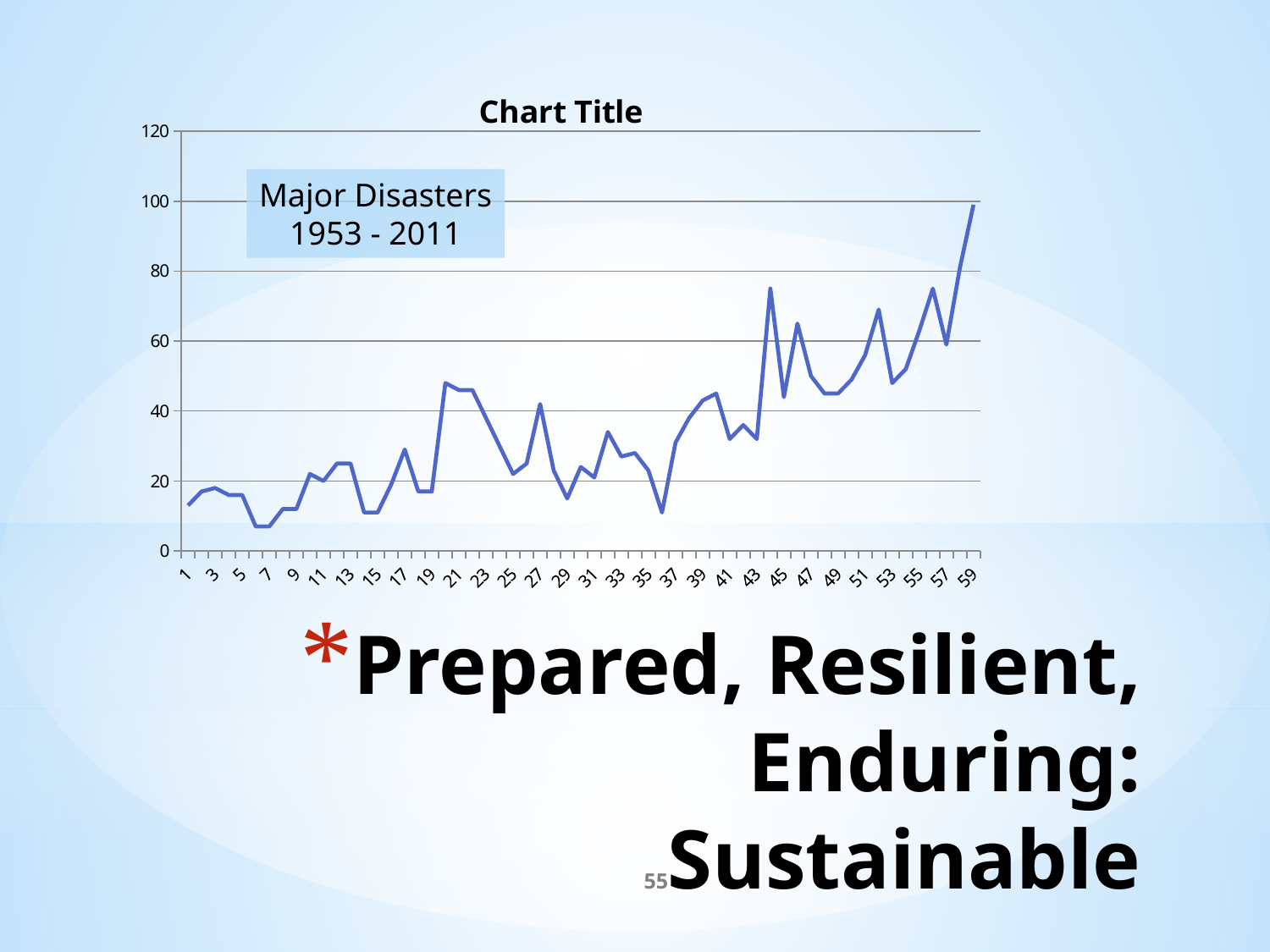
At which x-axis point does the line reach its highest value? 59 What kind of chart is shown on the slide? line chart Is the value at point 20 greater or less than 40? greater What is the highest value shown on the y axis? 120 What does the text box inside the chart say? Major Disasters 1953 - 2011 What is the title printed above the chart? Chart Title Is the value at point 1 greater or less than 20? less Is the value at point 44 greater or less than 60? greater Overall, do the values rise or fall from left to right along the x axis? rise Is the value at point 59 larger or smaller than the value at point 1? larger